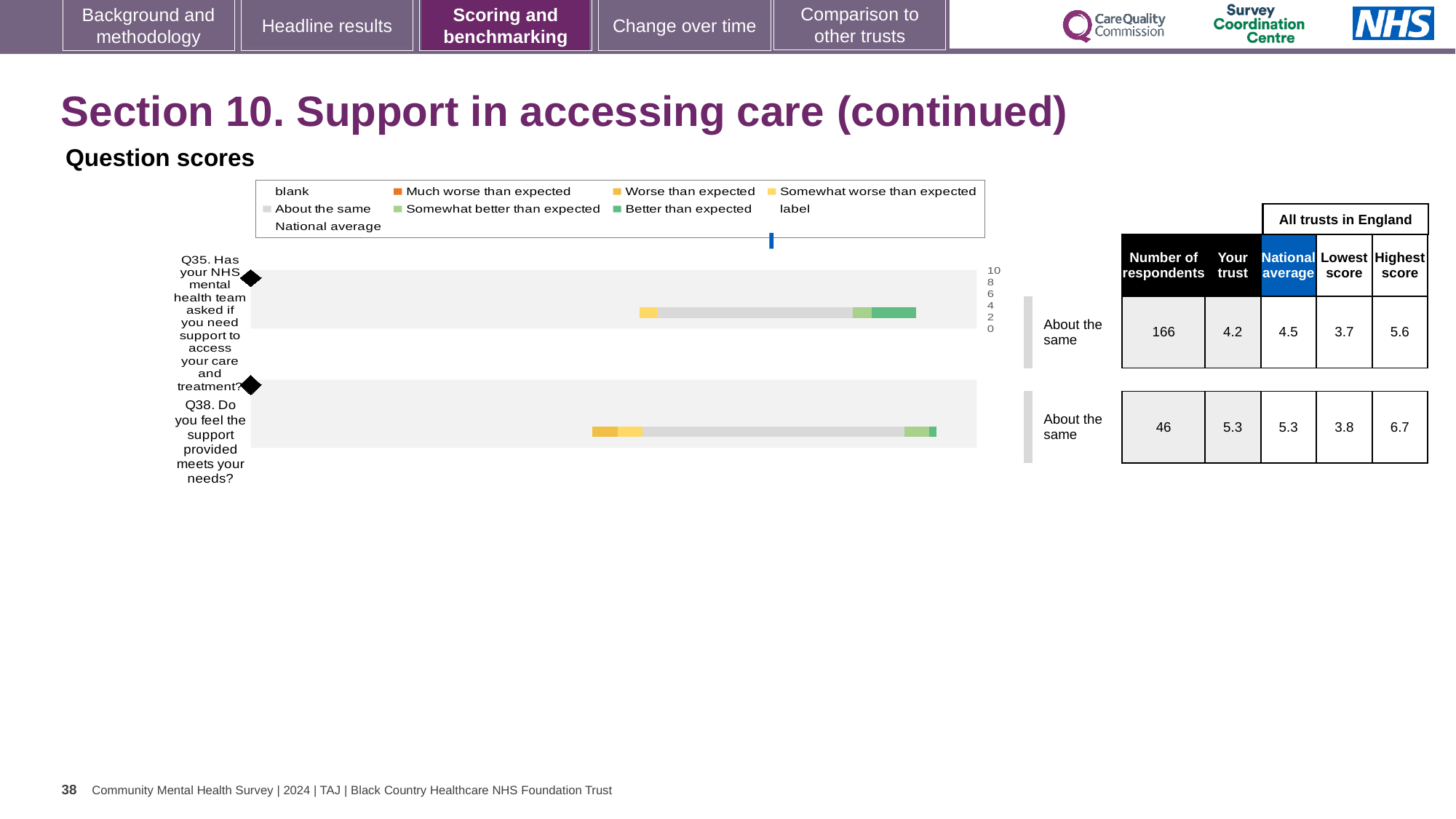
What benchmark category label is shown next to the bar for Q35? About the same What is the national average score for Q35? 4.5 What is the highest score among all trusts in England for Q38? 6.7 How many questions are plotted in the question scores chart? 2 What is the 'Your trust' score for Q38 (Do you feel the support provided meets your needs?)? 5.3 What is the number of respondents for Q35 in the question scores table? 166 For Q35, which is larger: the 'Your trust' score or the national average? National average What kind of chart is used to show the question scores on this slide? Bar chart What is the difference between the highest score and the lowest score for Q35? 1.9 Which question has the higher 'Your trust' score, Q35 or Q38? Q38 What colour does the legend use for 'Better than expected'? Green What is the lowest score among all trusts in England for Q38? 3.8